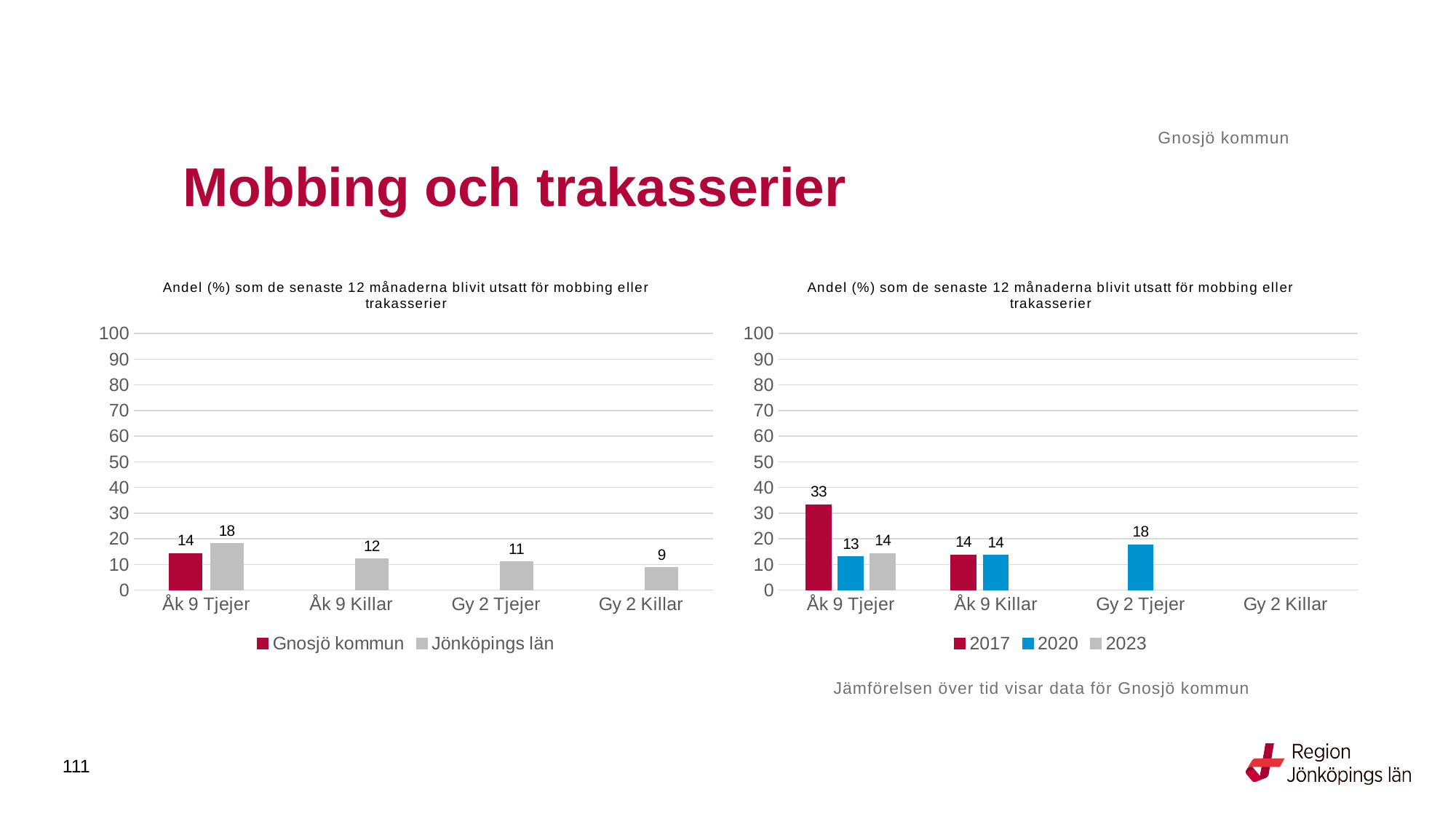
In the right chart, which year has the highest value for Åk 9 Tjejer? 2017 In the right chart, what is the difference between the 2017 and 2020 values for Åk 9 Tjejer? 20 In the left chart, what is the difference between Jönköpings län and Gnosjö kommun for Åk 9 Tjejer? 4 In the right chart, what is the value for 2020 for Gy 2 Tjejer? 18 What kind of chart is the left chart? Bar chart In the right chart, is the 2017 value for Åk 9 Tjejer greater or less than 30? greater In the right chart, how many series does the legend list? 3 In the left chart, how many series does the legend list? 2 In the left chart, which category has the lowest value for Jönköpings län? Gy 2 Killar In the left chart, what is the value for Gnosjö kommun for Åk 9 Tjejer? 14 In the left chart, what is the value for Jönköpings län for Åk 9 Tjejer? 18 In the right chart, what is the value for 2017 for Åk 9 Tjejer? 33